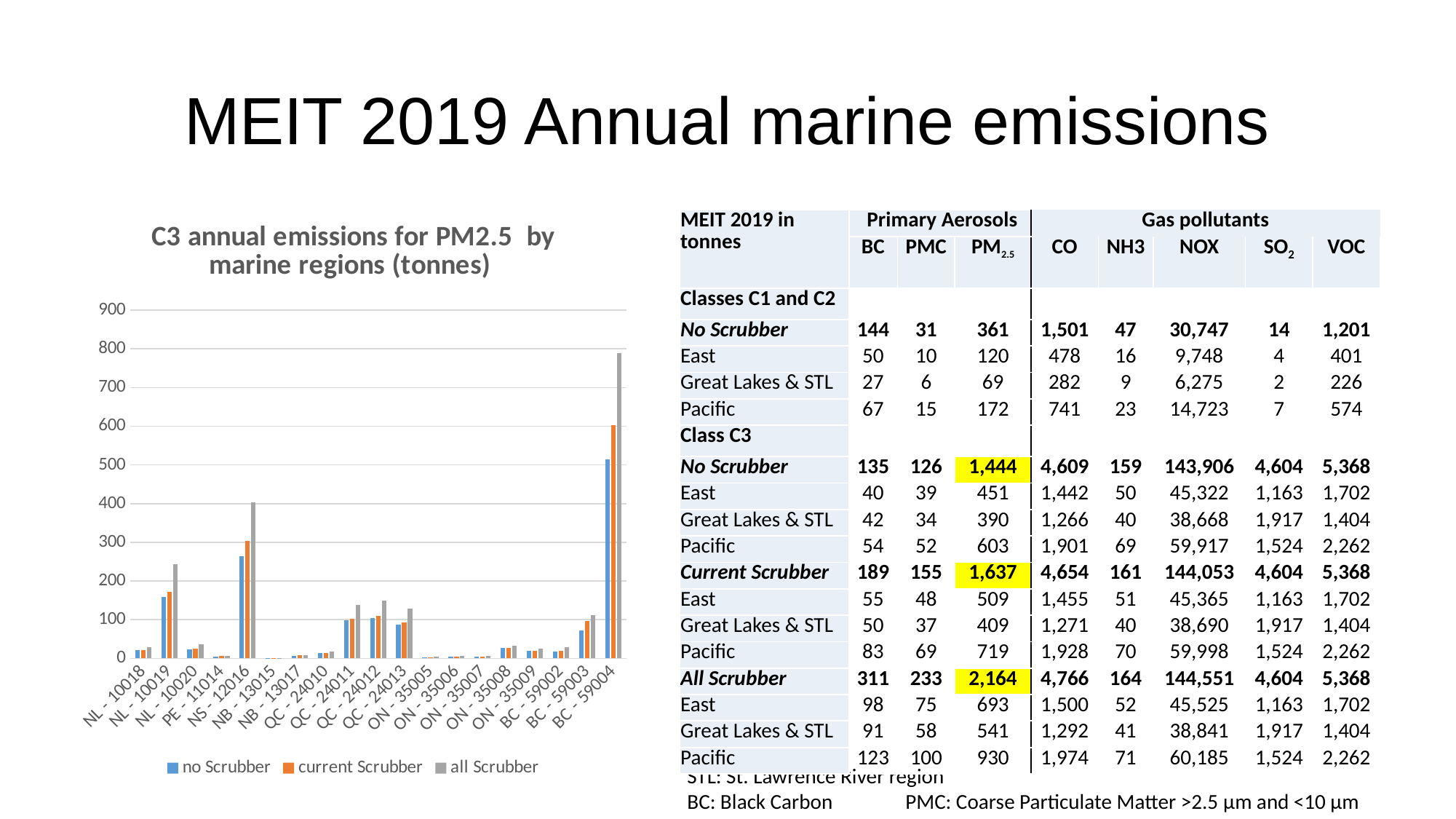
Is the all Scrubber value for NS - 12016 greater or less than 300? greater What kind of chart is shown on the slide? bar chart How many marine region categories are shown on the x axis of the chart? 19 Is the all Scrubber value for BC - 59004 greater or less than 700? greater Which marine region has the highest all Scrubber value in the chart? BC - 59004 Is the all Scrubber value for NL - 10019 greater or less than 200? greater How many series does the legend of the chart list? 3 Which has the larger no Scrubber value, NS - 12016 or NL - 10019? NS - 12016 What is the title of the chart on the slide? C3 annual emissions for PM2.5 by marine regions (tonnes) Which has the larger current Scrubber value, BC - 59004 or NS - 12016? BC - 59004 Which marine region has the highest no Scrubber value in the chart? BC - 59004